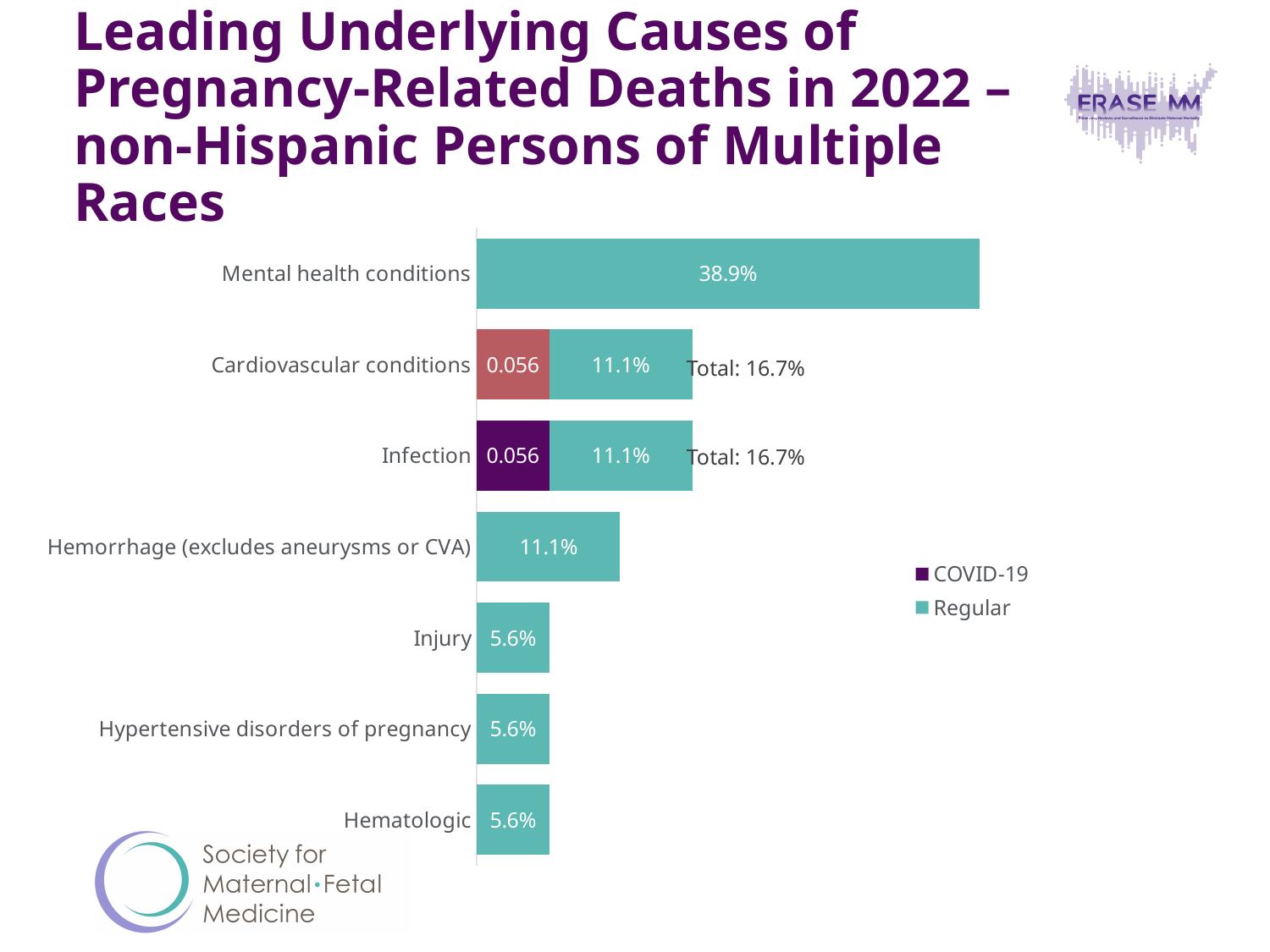
What is the value for Hypertensive disorders of pregnancy? 5.6% How many categories are shown on the chart? 7 What is the value for Hemorrhage (excludes aneurysms or CVA)? 11.1% What is the Regular value for Cardiovascular conditions? 11.1% What is the difference between the value for Mental health conditions and the value for Hemorrhage (excludes aneurysms or CVA)? 27.8% What is the COVID-19 value for Infection? 0.056 What is the total for the Infection bar? 16.7% What is the value for Mental health conditions? 38.9% What kind of chart is shown on the slide? Stacked horizontal bar chart Which category has the highest value? Mental health conditions How many series does the legend list? 2 Which is larger, the value for Hemorrhage (excludes aneurysms or CVA) or the value for Injury? Hemorrhage (excludes aneurysms or CVA)